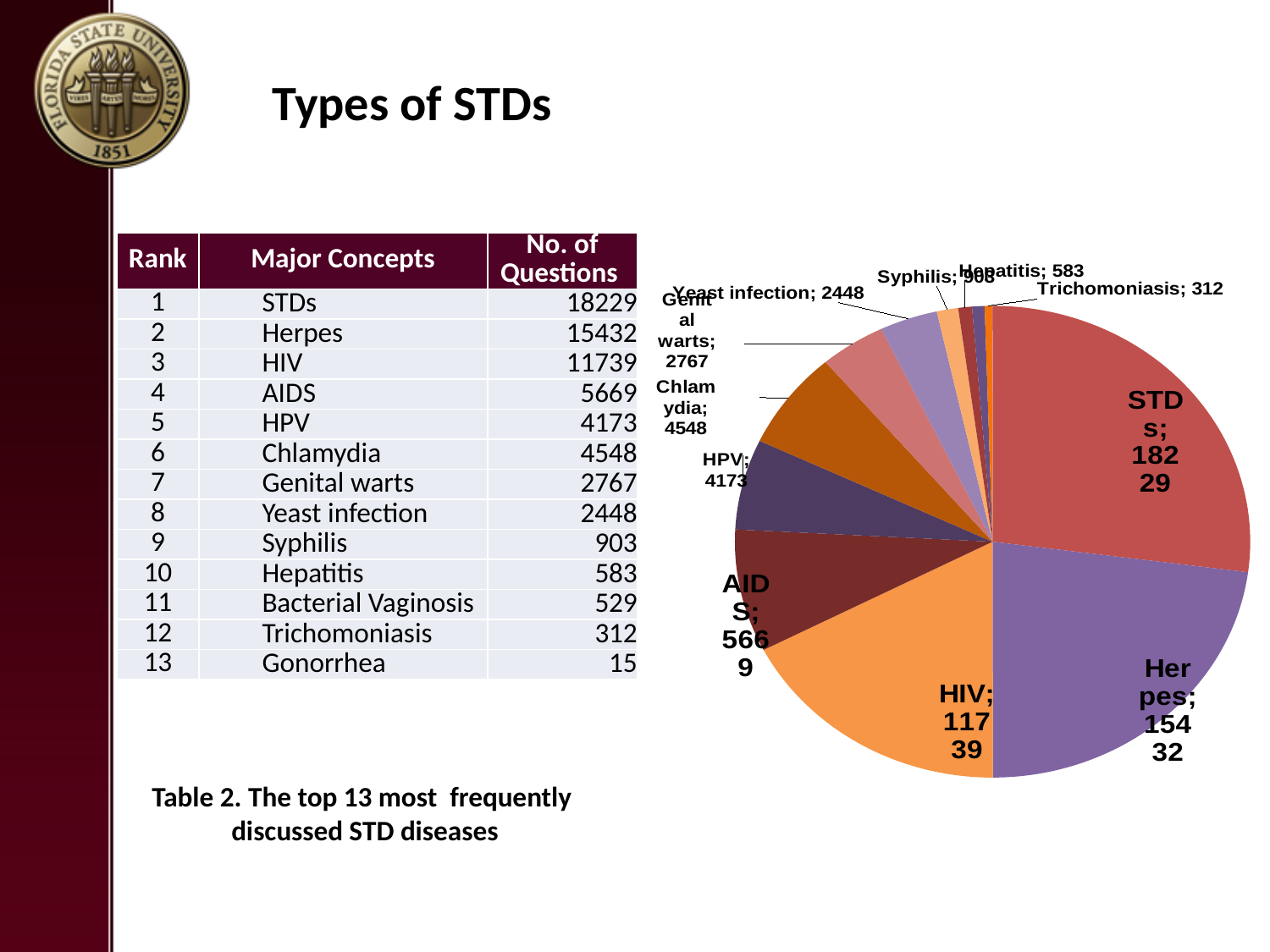
Which category has the largest slice in the pie chart? STDs In the pie chart, what is the difference between the values for STDs and Herpes? 2797 What is the title of the slide containing the pie chart? Types of STDs In the pie chart, what is the value for HIV? 11739 In the pie chart, what is the value for Chlamydia? 4548 In the pie chart, what is the value for Hepatitis? 583 In the pie chart, what is the difference between the values for HIV and AIDS? 6070 In the pie chart, what is the value for Herpes? 15432 In the pie chart, what is the value for Trichomoniasis? 312 What kind of chart is shown on the slide? pie chart In the pie chart, what is the value for STDs? 18229 In the pie chart, which is larger, the value for Chlamydia or the value for HPV? Chlamydia